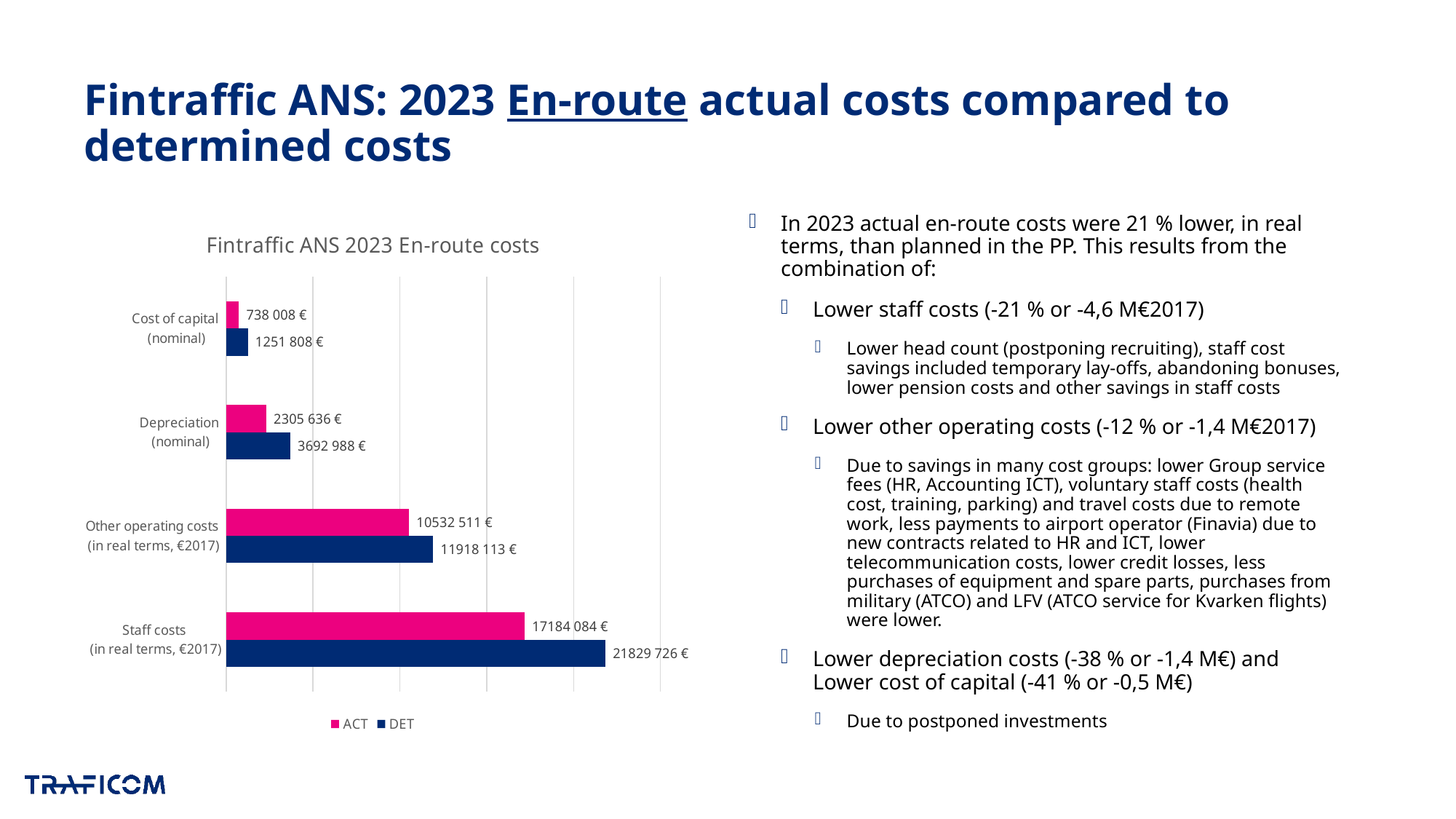
What is the DET value for Other operating costs (in real terms, €2017)? 11918 113 € What is the difference between the DET and ACT values for Staff costs (in real terms, €2017)? 4645 642 € What is the DET value for Depreciation (nominal)? 3692 988 € How many cost categories are shown in the chart? 4 What is the ACT value for Cost of capital (nominal)? 738 008 € What type of chart is shown on the slide? Bar chart Which category has the highest DET value? Staff costs (in real terms, €2017) For Other operating costs (in real terms, €2017), which is larger, the ACT value or the DET value? DET What is the difference between the DET and ACT values for Cost of capital (nominal)? 513 800 € Which category has the lowest ACT value? Cost of capital (nominal) What is the ACT value for Staff costs (in real terms, €2017)? 17184 084 € How many series does the legend list? 2